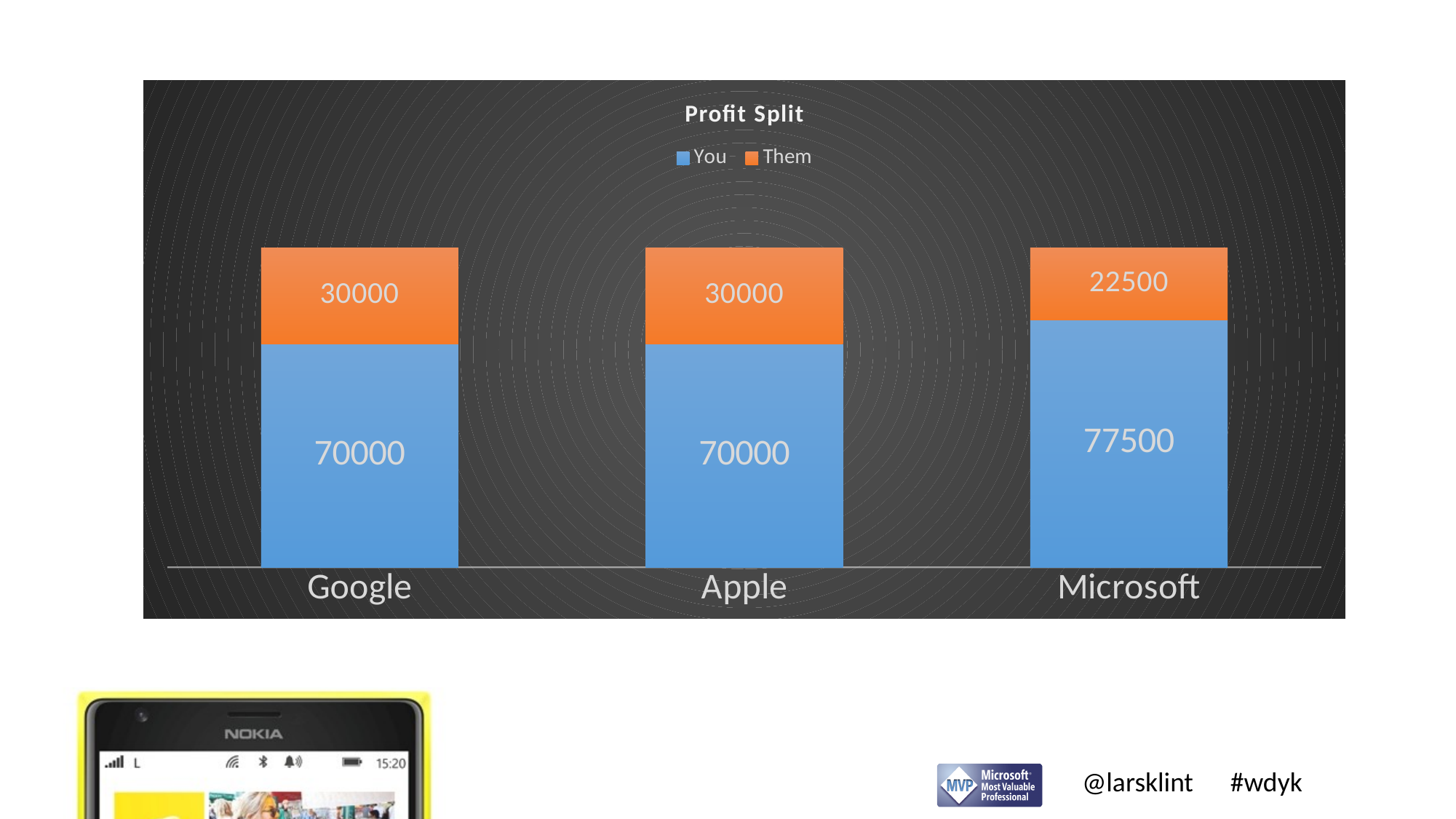
What is the total of the stacked bar for Microsoft? 100000 Which category has the lowest value for Them? Microsoft What is the difference between the You value for Microsoft and the You value for Google? 7500 How many series does the legend list? 2 Is the Them value for Apple larger or smaller than the Them value for Microsoft? larger Which category has the highest value for You? Microsoft What is the title of the chart? Profit Split How many categories are shown on the x axis? 3 What is the value for Them for Microsoft? 22500 What kind of chart is shown? stacked bar chart What is the value for Them for Apple? 30000 What is the value for You for Google? 70000